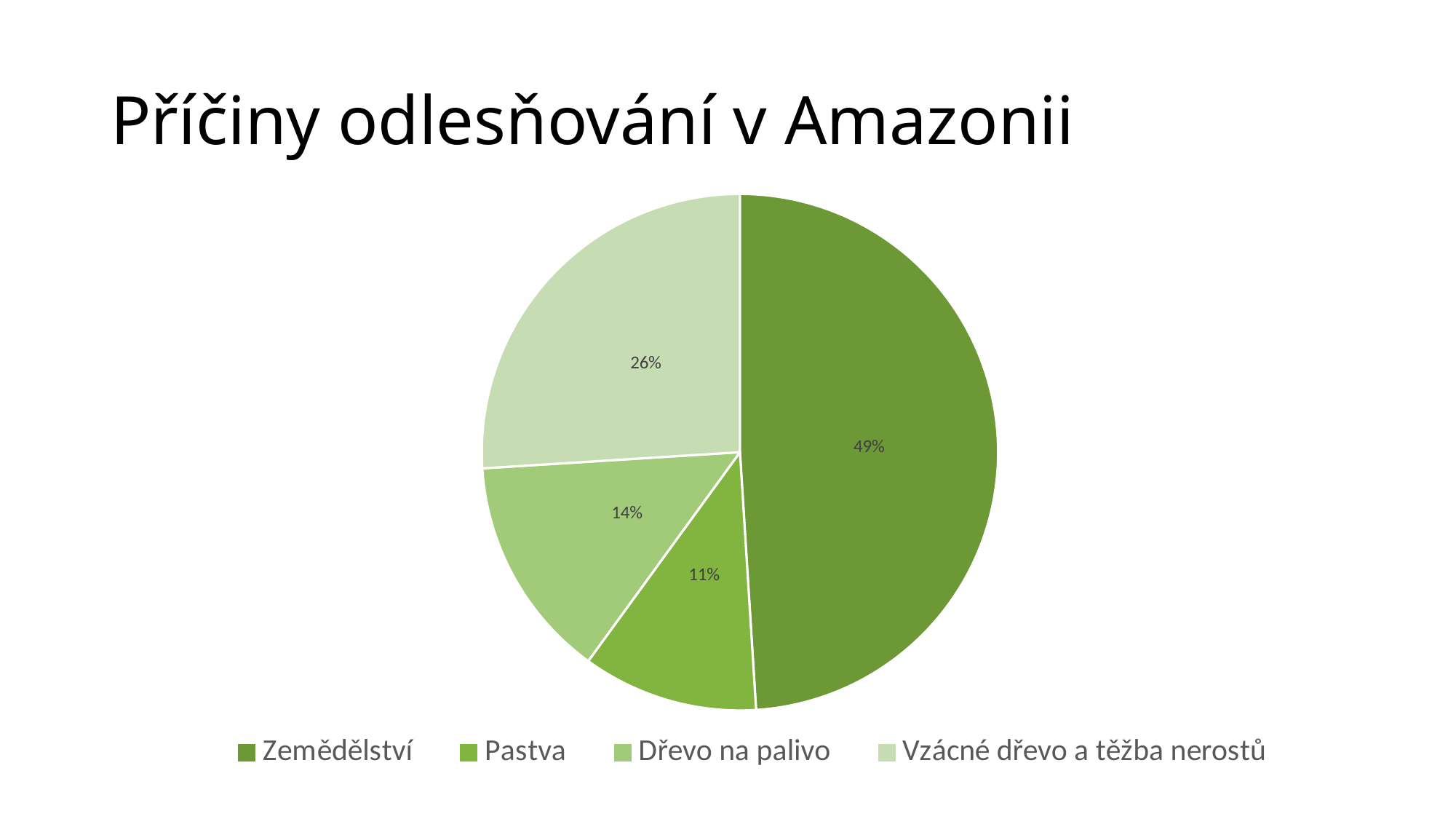
What kind of chart is shown on the slide? pie chart Which is larger, the slice for Dřevo na palivo or the slice for Pastva? Dřevo na palivo What share of the pie does Dřevo na palivo have? 14% What is the difference in percentage points between Zemědělství and Vzácné dřevo a těžba nerostů? 23 What share of the pie does Vzácné dřevo a těžba nerostů have? 26% What is the title of the chart on the slide? Příčiny odlesňování v Amazonii How many entries does the legend list? 4 What share of the pie does Pastva have? 11% Which category has the smallest slice of the pie? Pastva How many categories does the pie chart show? 4 Which category has the largest slice of the pie? Zemědělství